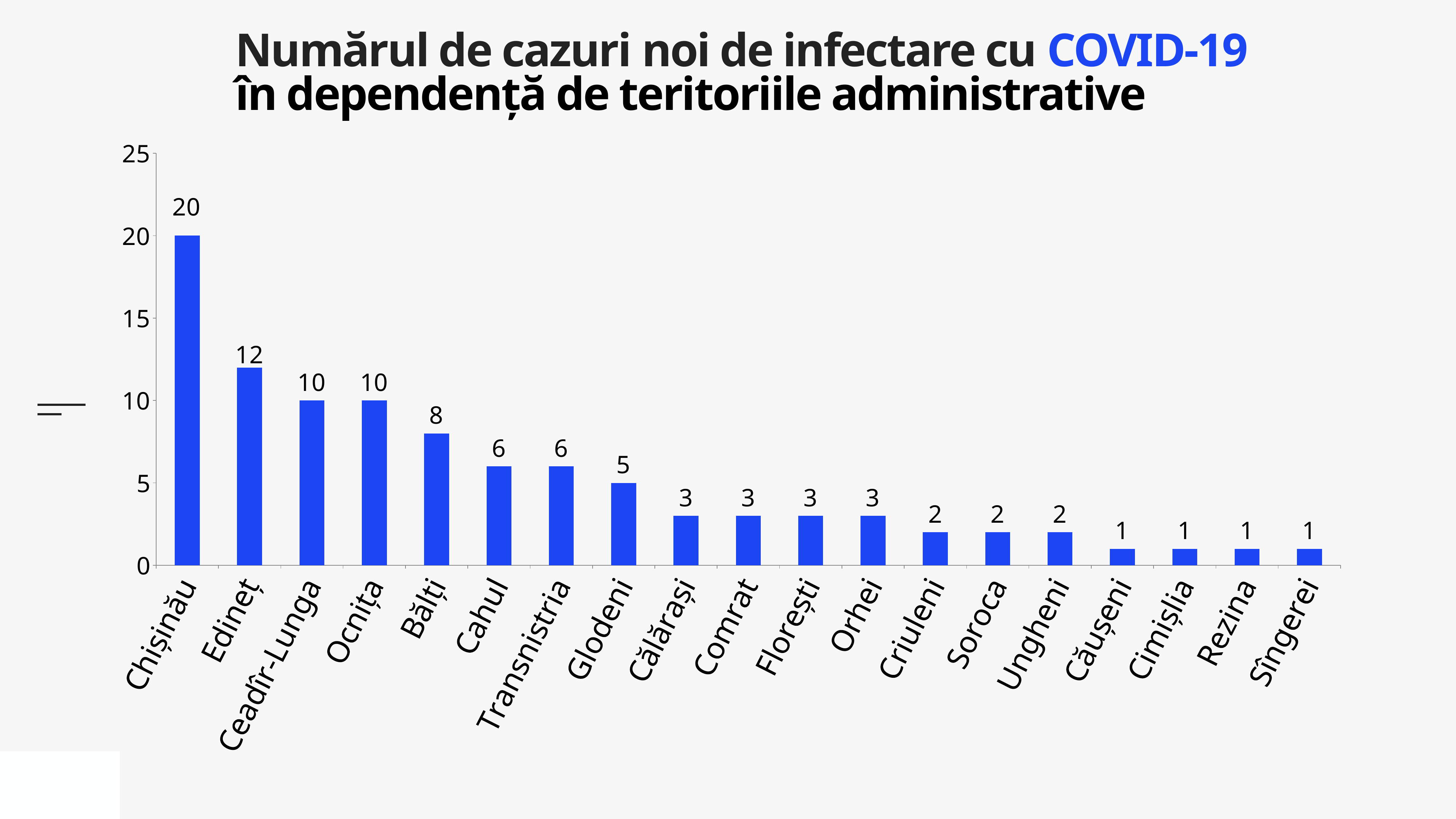
How many territories are shown on the x axis? 19 What is the value for Bălți? 8 Which territory has the highest number of new cases? Chișinău Do the values rise or fall from left to right along the x axis? fall What is the value for Glodeni? 5 What is the difference between the values for Bălți and Cahul? 2 Is the value for Chișinău greater or less than 15? greater What is the value for Chișinău? 20 What is the difference between the values for Chișinău and Edineț? 8 Which is larger, the value for Ocnița or the value for Orhei? Ocnița What kind of chart is shown on the slide? bar chart What is the value for Edineț? 12